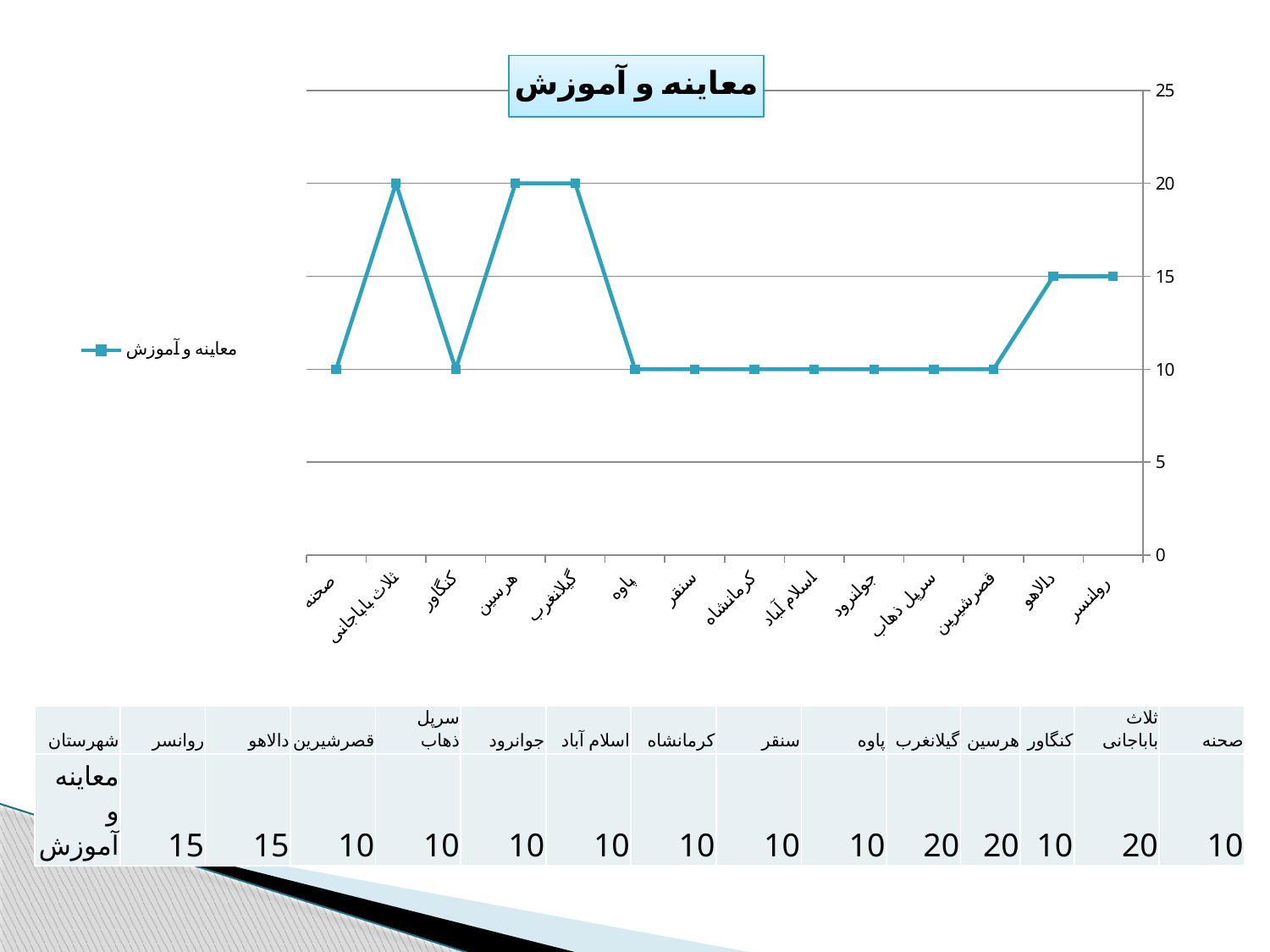
What kind of chart is shown on the slide? line chart How many categories are plotted along the x axis? 14 What is the value for روانسر? 15 Which has the larger value, دالاهو or کنگاور? دالاهو What is the value for دالاهو? 15 What is the highest value plotted on the chart? 20 Is the value for گیلانغرب greater or less than 15? greater What is the title of the chart? معاینه و آموزش What is the difference between the values for هرسین and پاوه? 10 What is the value for کرمانشاه? 10 What is the value for ثلاث باباجانی? 20 How many series does the legend list? 1